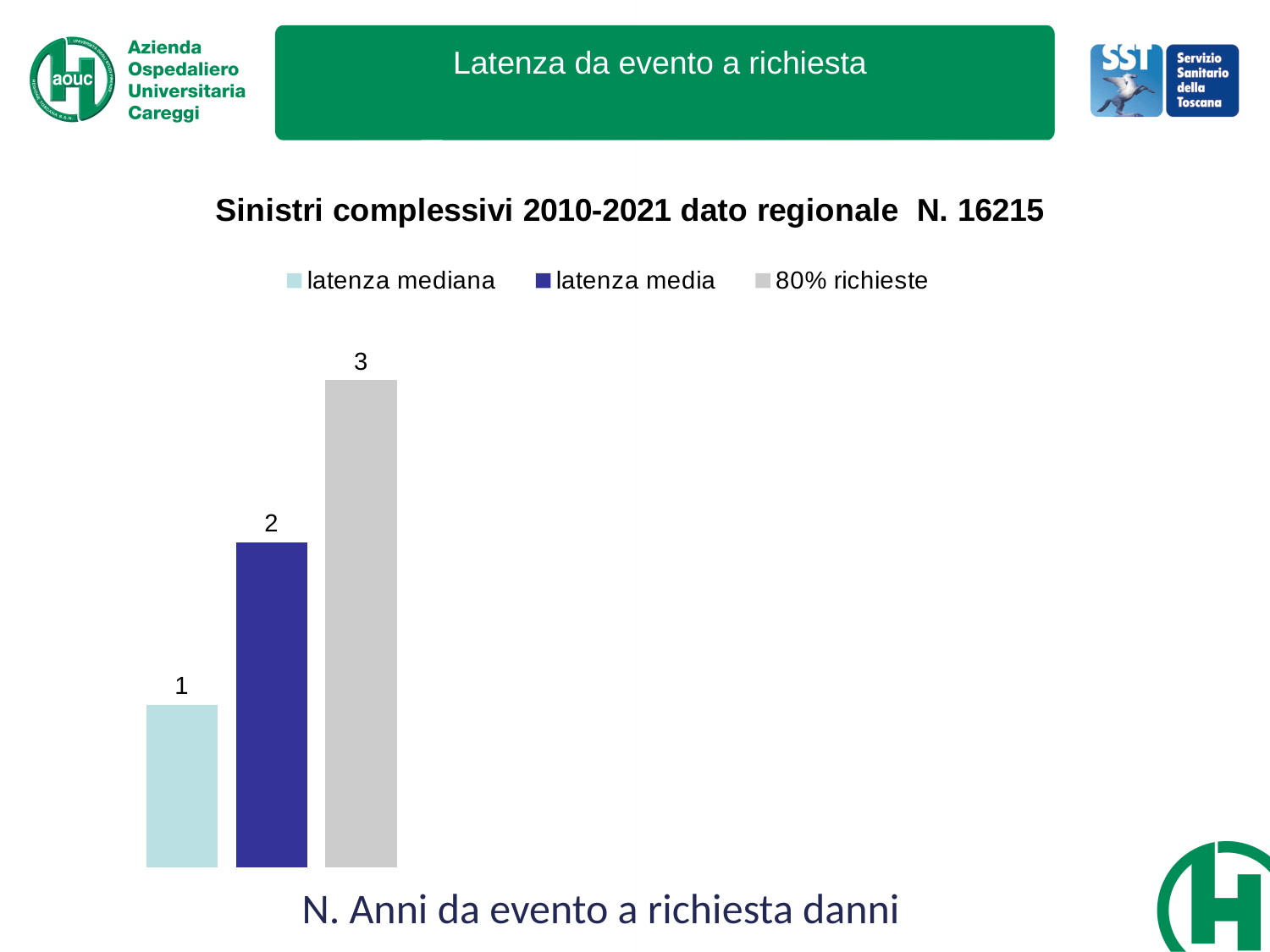
What is the value for latenza mediana? 1 What is the title of the chart? Sinistri complessivi 2010-2021 dato regionale N. 16215 What kind of chart is shown on the slide? bar chart Which is larger, the value for latenza media or the value for latenza mediana? latenza media What is the difference between the values for latenza media and latenza mediana? 1 What is the difference between the values for 80% richieste and latenza mediana? 2 How many bars are plotted in the chart? 3 How many series does the legend list? 3 What is the value for 80% richieste? 3 What is the value for latenza media? 2 Which series has the highest value? 80% richieste Which series has the lowest value? latenza mediana